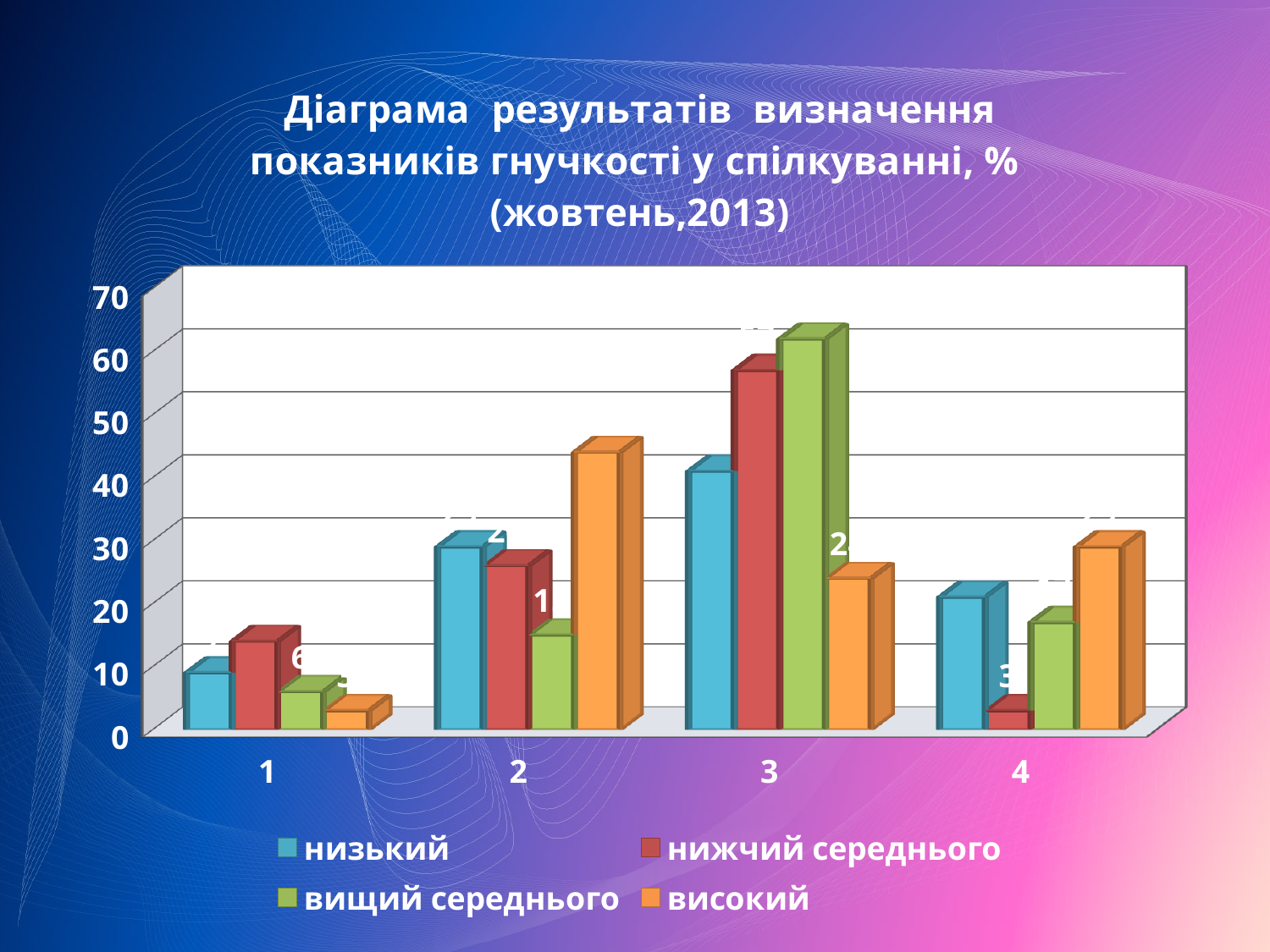
In which category is the value for високий the lowest? 1 Is the value for низький in category 3 greater or less than 30? greater In category 1, which series has the highest value? нижчий середнього Is the value for високий in category 2 greater or less than 40? greater How many series does the legend list? 4 Is the value for нижчий середнього in category 4 greater or less than 10? less In which category is the value for вищий середнього the highest? 3 In category 2, which is larger: високий or низький? високий What colour represents the series високий in the legend? orange In category 3, which is larger: вищий середнього or високий? вищий середнього What kind of chart is shown on the slide? bar chart How many categories are shown along the x axis? 4